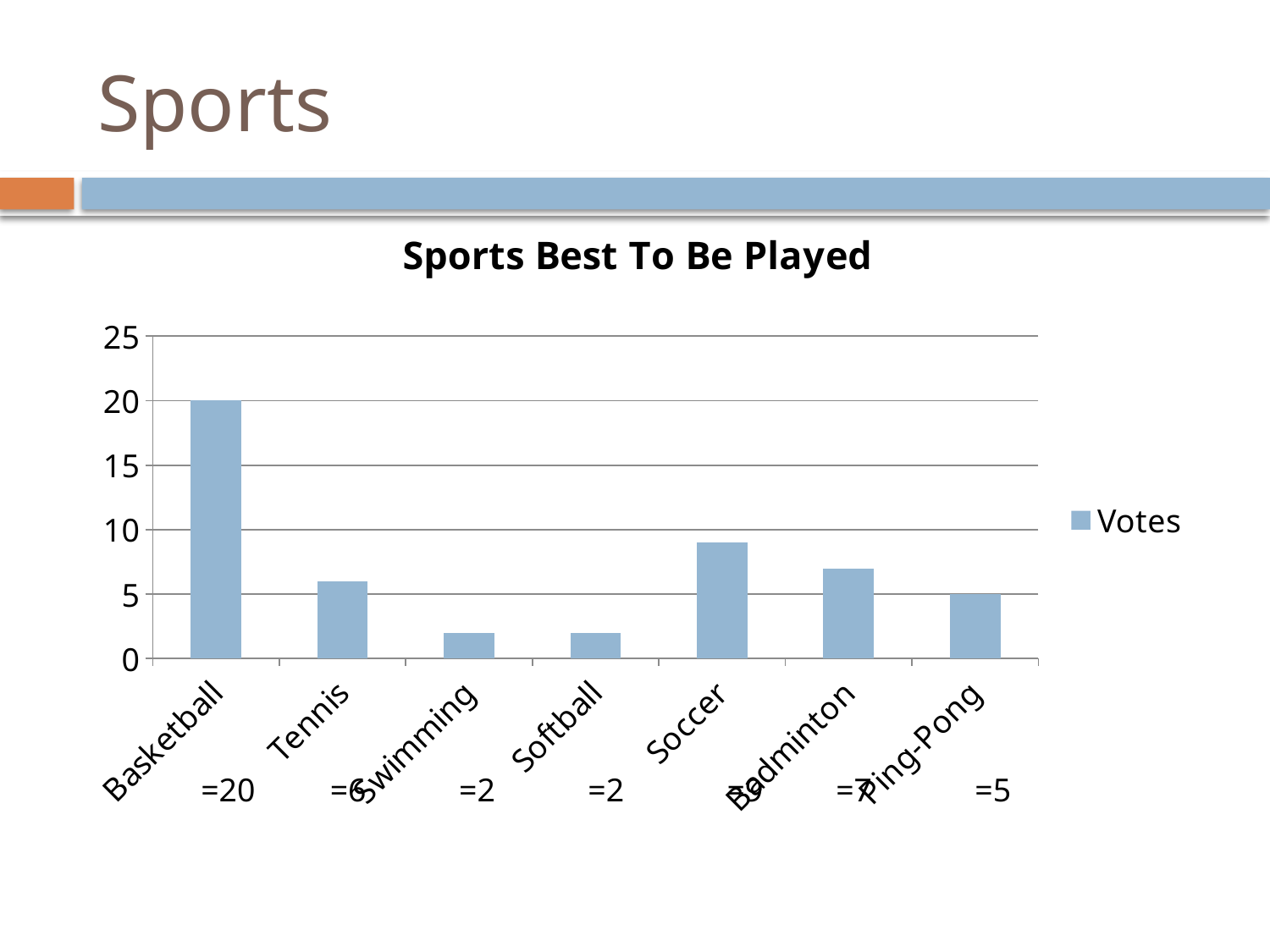
What is the value for Ping-Pong in the Sports Best To Be Played chart? 5 How many votes does Tennis have in the Sports Best To Be Played chart? 6 Which has more votes, Soccer or Badminton? Soccer What kind of chart is shown on the slide? bar chart What is the value for Basketball in the Sports Best To Be Played chart? 20 How many series does the legend list? 1 Which sport has the highest number of votes in the Sports Best To Be Played chart? Basketball What is the value for Swimming in the Sports Best To Be Played chart? 2 Is the value for Soccer greater or less than 10? less What is the difference between the votes for Basketball and Tennis? 14 Is the value for Badminton greater or less than 5? greater How many sports are shown on the x axis of the chart? 7